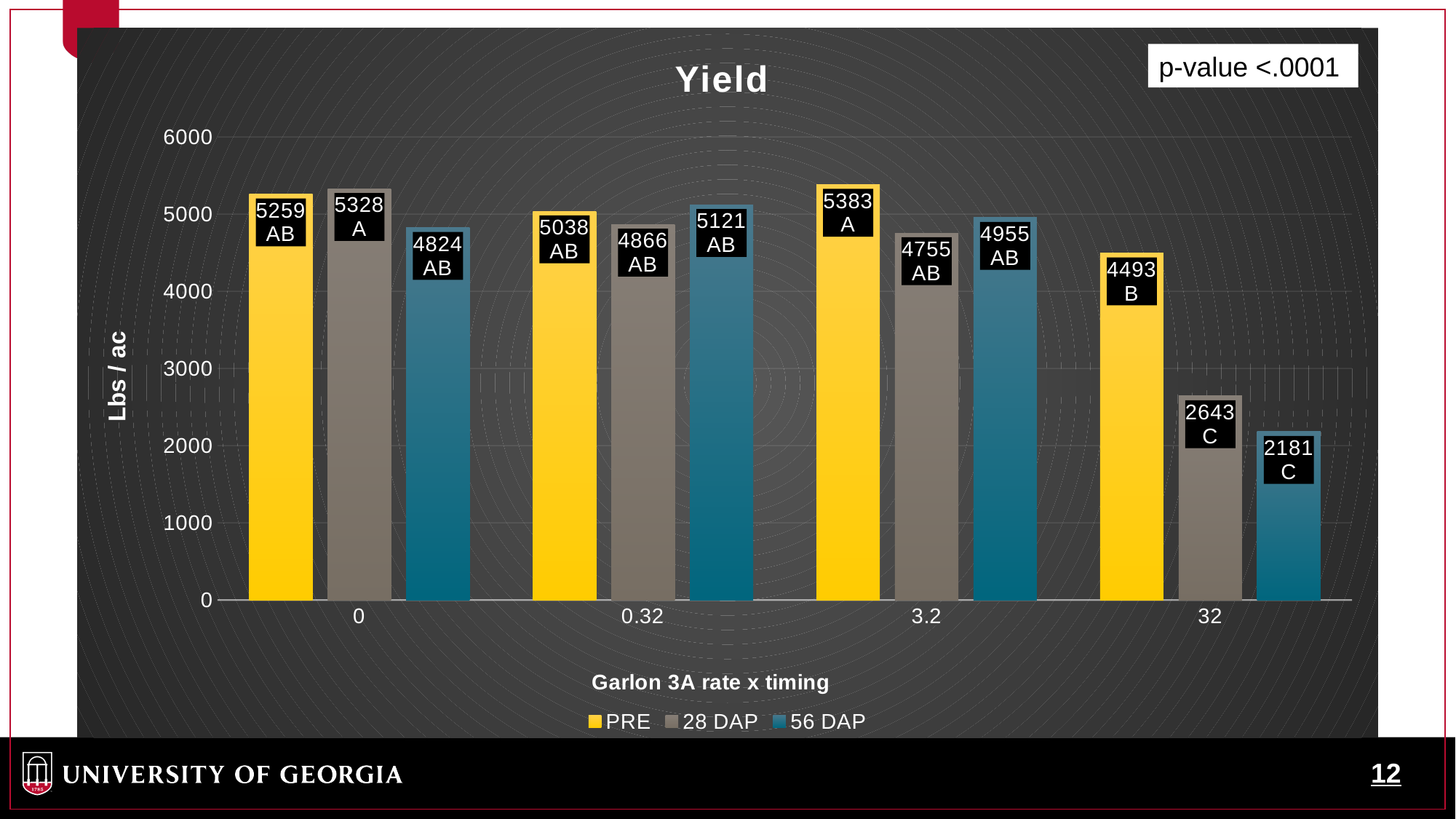
Which is larger at the 0.32 rate, the PRE yield or the 56 DAP yield? 56 DAP How many rate categories are shown on the x axis? 4 Which rate has the lowest 28 DAP yield? 32 What kind of chart is shown on the slide? bar chart Which rate has the highest PRE yield? 3.2 What is the yield for the 56 DAP series at the 32 rate? 2181 How many series does the legend list? 3 What is the yield for the 28 DAP series at the 3.2 rate? 4755 What is the title of the chart? Yield What is the yield for the PRE series at the 0 rate? 5259 Is the 56 DAP yield at the 32 rate greater or less than 3000? less What is the difference between the PRE and 28 DAP yields at the 32 rate? 1850